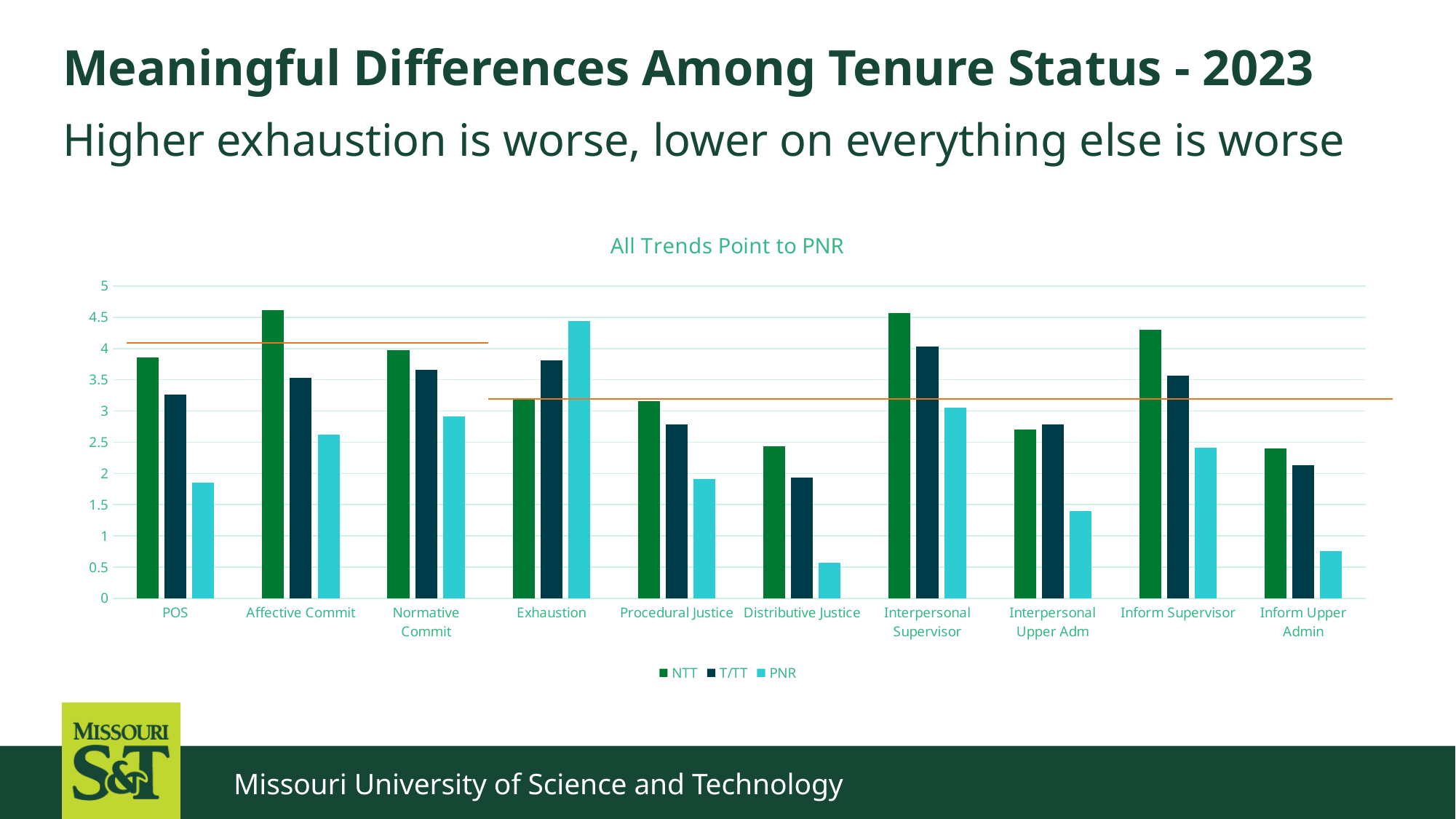
Is the T/TT value for Distributive Justice greater or less than 2.5? less What are the three series named in the legend? NTT, T/TT, PNR How many categories are shown along the x axis? 10 What kind of chart is shown on the slide? bar chart How many series does the legend list? 3 Is the NTT value for Affective Commit greater or less than 4? greater For Interpersonal Supervisor, which is larger: the NTT value or the T/TT value? NTT Which category has the highest PNR value? Exhaustion Is the PNR value for POS greater or less than 2? less Which category has the lowest PNR value? Distributive Justice What is the title of the chart? All Trends Point to PNR For Exhaustion, which is larger: the NTT value or the PNR value? PNR